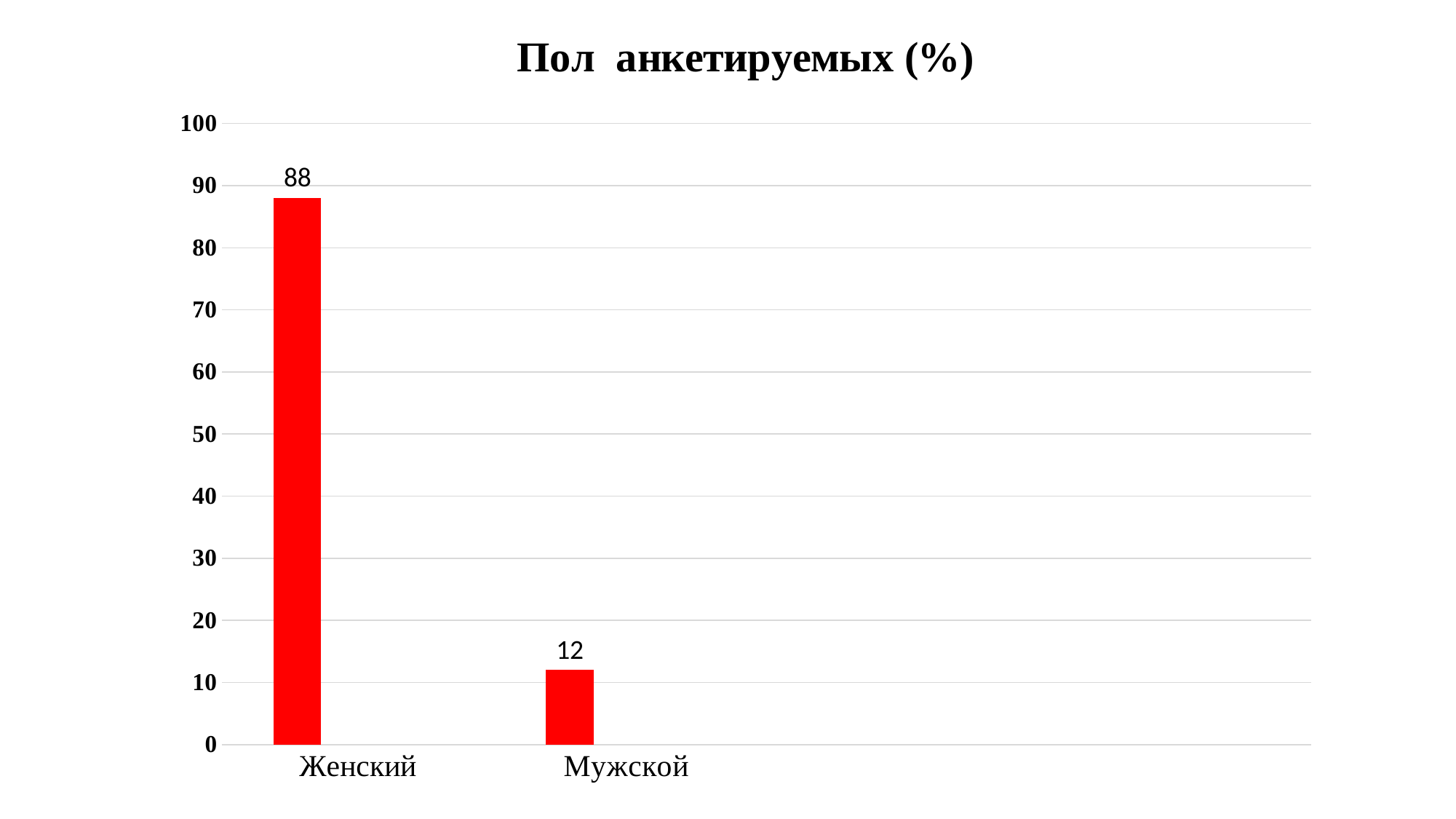
How many categories are shown on the x axis? 2 Is the value for Женский greater or less than 80? greater Which category has the highest value? Женский What is the value for Женский? 88 What is the value for Мужской? 12 Which is larger, the value for Женский or the value for Мужской? Женский What kind of chart is shown on the slide? bar chart What is the difference between the values for Женский and Мужской? 76 Which category has the lowest value? Мужской What colour are the bars in the chart? red Is the value for Мужской greater or less than 20? less What is the title of the chart? Пол анкетируемых (%)